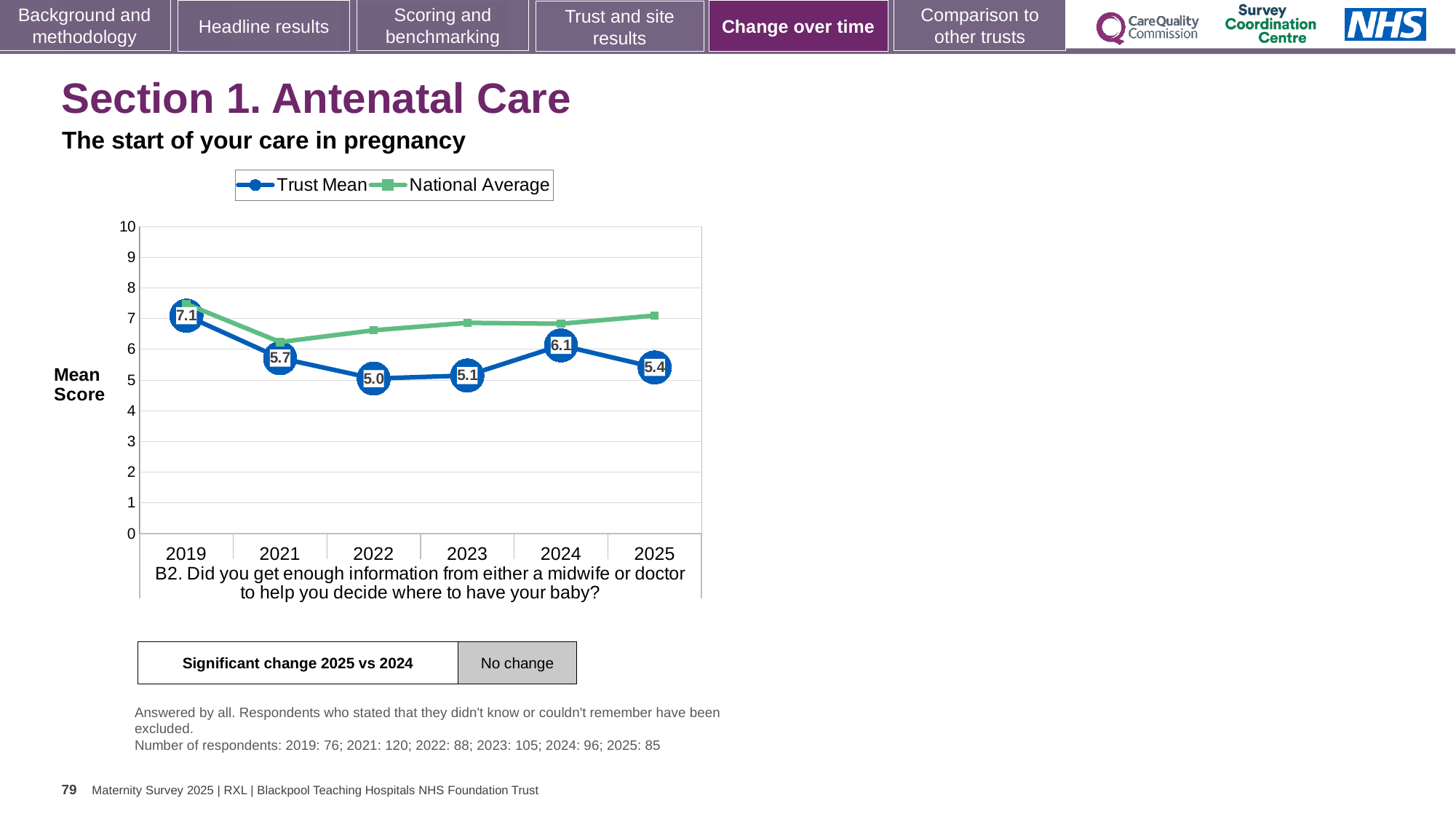
In which year is the Trust Mean lowest? 2022 How many years are shown on the x axis? 6 What kind of chart is shown on the slide? Line chart How many series does the legend list? 2 In which year is the Trust Mean highest? 2019 Which is larger, the Trust Mean in 2021 or in 2023? 2021 Does the Trust Mean rise or fall from 2019 to 2022? Fall What is the difference between the Trust Mean in 2024 and in 2025? 0.7 What is the Trust Mean score for 2025? 5.4 What is the Trust Mean score for 2019? 7.1 What is the Trust Mean score for 2022? 5.0 Is the National Average for 2025 greater or less than 6? greater